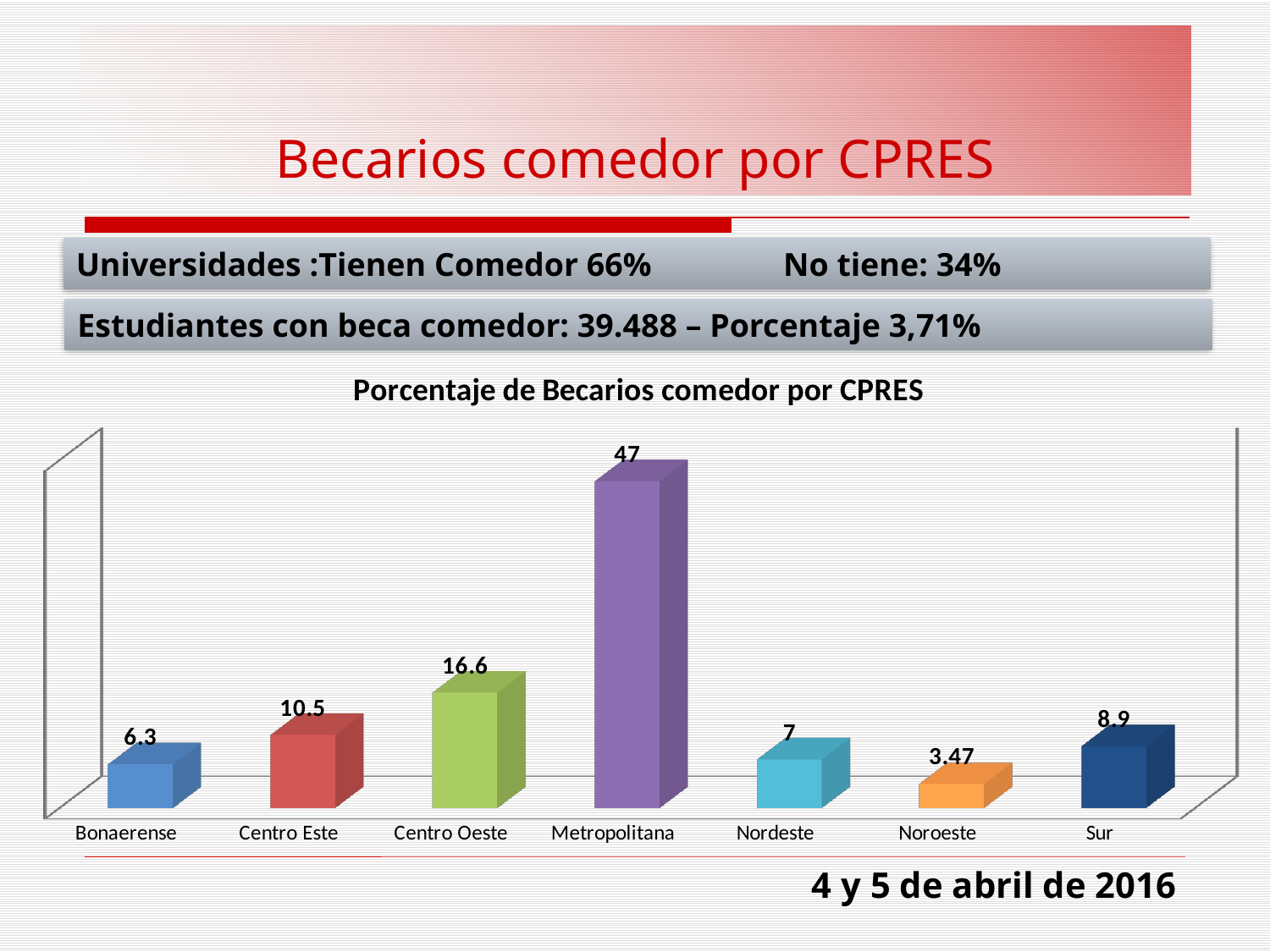
What is the title of the chart? Porcentaje de Becarios comedor por CPRES Which is larger, the value for Sur or the value for Nordeste? Sur What is the value for Metropolitana? 47 What is the difference between the values for Centro Oeste and Centro Este? 6.1 What is the value for Sur? 8.9 What is the value for Centro Oeste? 16.6 Which category has the lowest value? Noroeste Which category has the highest value? Metropolitana What is the value for Noroeste? 3.47 What kind of chart is shown? Bar chart What colour is the bar for Metropolitana? Purple How many categories are shown on the x axis? 7